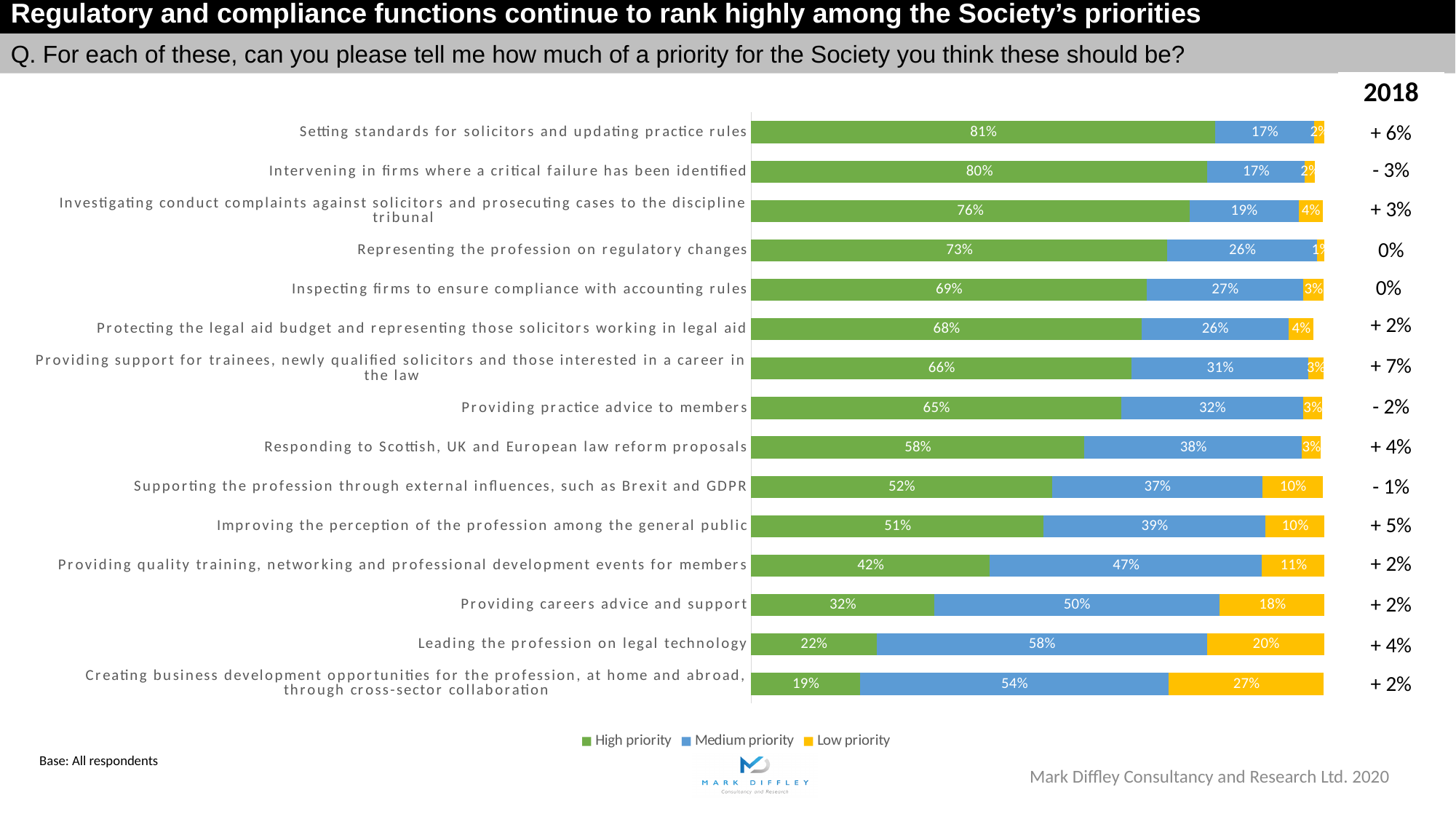
How many categories are shown in the chart? 15 What is the low priority value for "Creating business development opportunities for the profession, at home and abroad, through cross-sector collaboration"? 27% What is the total of the high and medium priority values for "Improving the perception of the profession among the general public"? 90% What percentage of respondents rated "Providing careers advice and support" as a high priority? 32% How many series does the legend list? 3 What is the difference between the high priority values for "Setting standards for solicitors and updating practice rules" and "Providing practice advice to members"? 16% What is the medium priority value for "Leading the profession on legal technology"? 58% Which has a larger medium priority value: "Providing quality training, networking and professional development events for members" or "Responding to Scottish, UK and European law reform proposals"? Providing quality training, networking and professional development events for members What kind of chart is shown on the slide? Stacked bar chart Which category has the highest high priority value? Setting standards for solicitors and updating practice rules Which colour represents the low priority series in the chart? Yellow Which category has the lowest high priority value? Creating business development opportunities for the profession, at home and abroad, through cross-sector collaboration